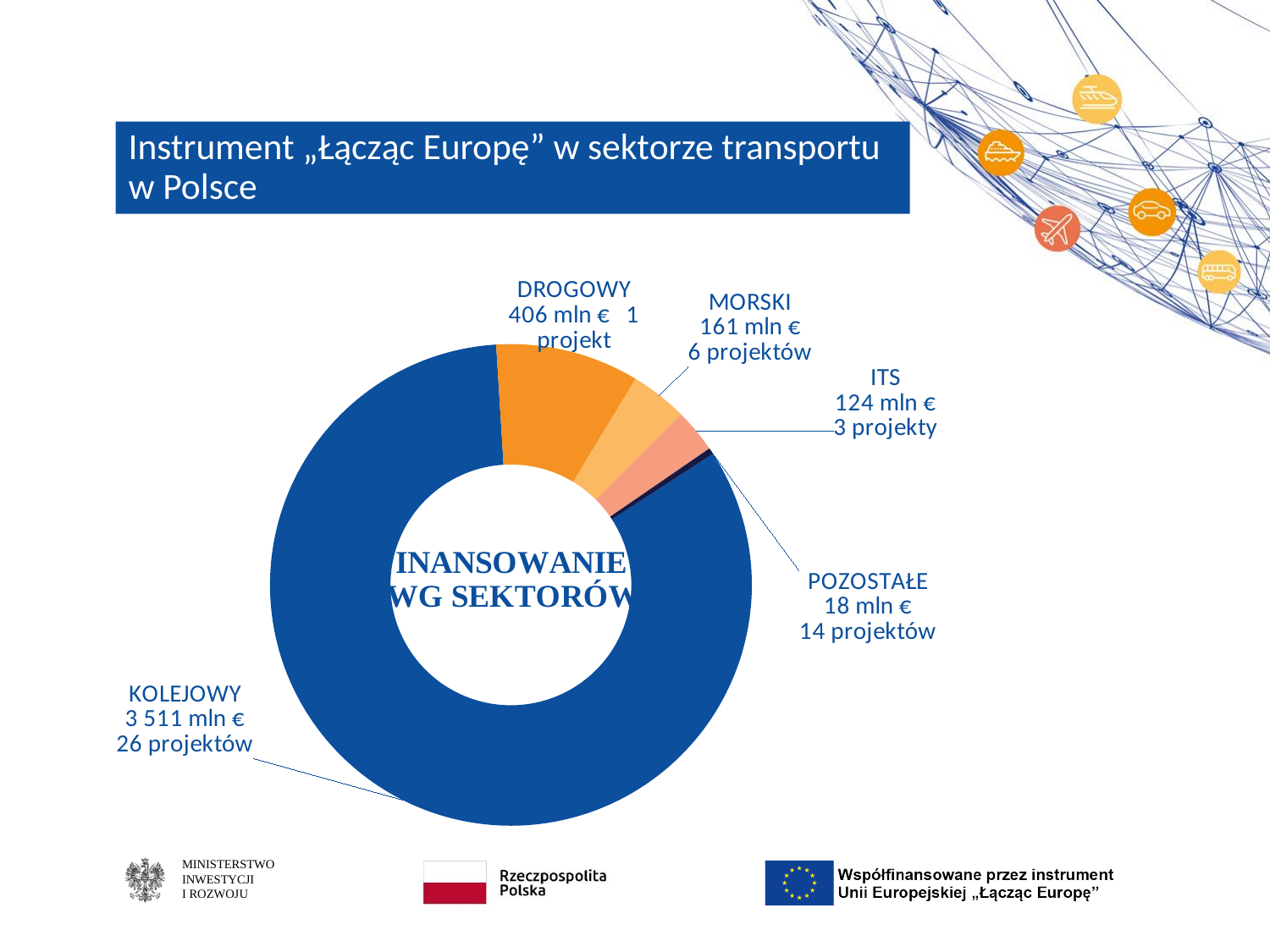
How many projects are in the POZOSTAŁE sector? 14 projektów Which sector has more funding, MORSKI or ITS? MORSKI What is the funding amount for the ITS sector? 124 mln € What text is shown in the centre of the donut chart? INANSOWANIE WG SEKTORÓW What is the funding amount for the KOLEJOWY sector? 3 511 mln € How many sectors are shown in the chart? 5 What is the funding amount for the DROGOWY sector? 406 mln € Which sector has the largest funding amount? KOLEJOWY Which sector has the smallest funding amount? POZOSTAŁE What is the difference in funding between the KOLEJOWY and DROGOWY sectors? 3 105 mln € What kind of chart is shown on the slide? Pie (donut) chart How many projects are in the MORSKI sector? 6 projektów